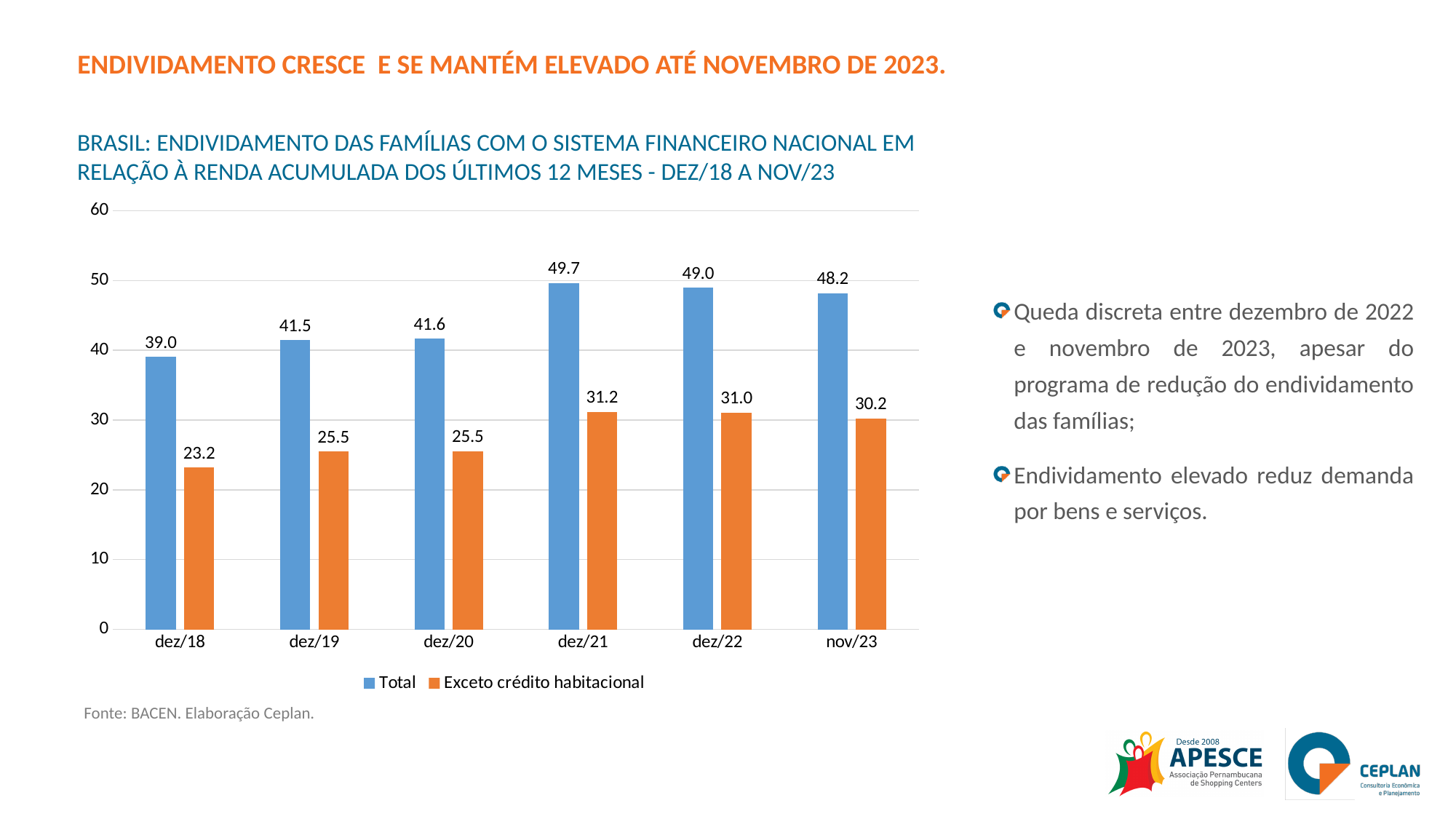
What is the difference between the Total and Exceto crédito habitacional values for dez/22? 18.0 How many series does the legend list? 2 What is the value of Exceto crédito habitacional for nov/23? 30.2 How many periods are shown on the x axis? 6 What kind of chart is shown on the slide? Bar chart What is the Total value for dez/18? 39.0 What is the difference between the Total values for dez/21 and dez/18? 10.7 Which period has the lowest value for Exceto crédito habitacional? dez/18 Which colour represents the Total series? Blue Which is larger: the Total value for dez/19 or the Total value for dez/20? dez/20 Which period has the highest Total value? dez/21 What is the Total value for dez/21? 49.7